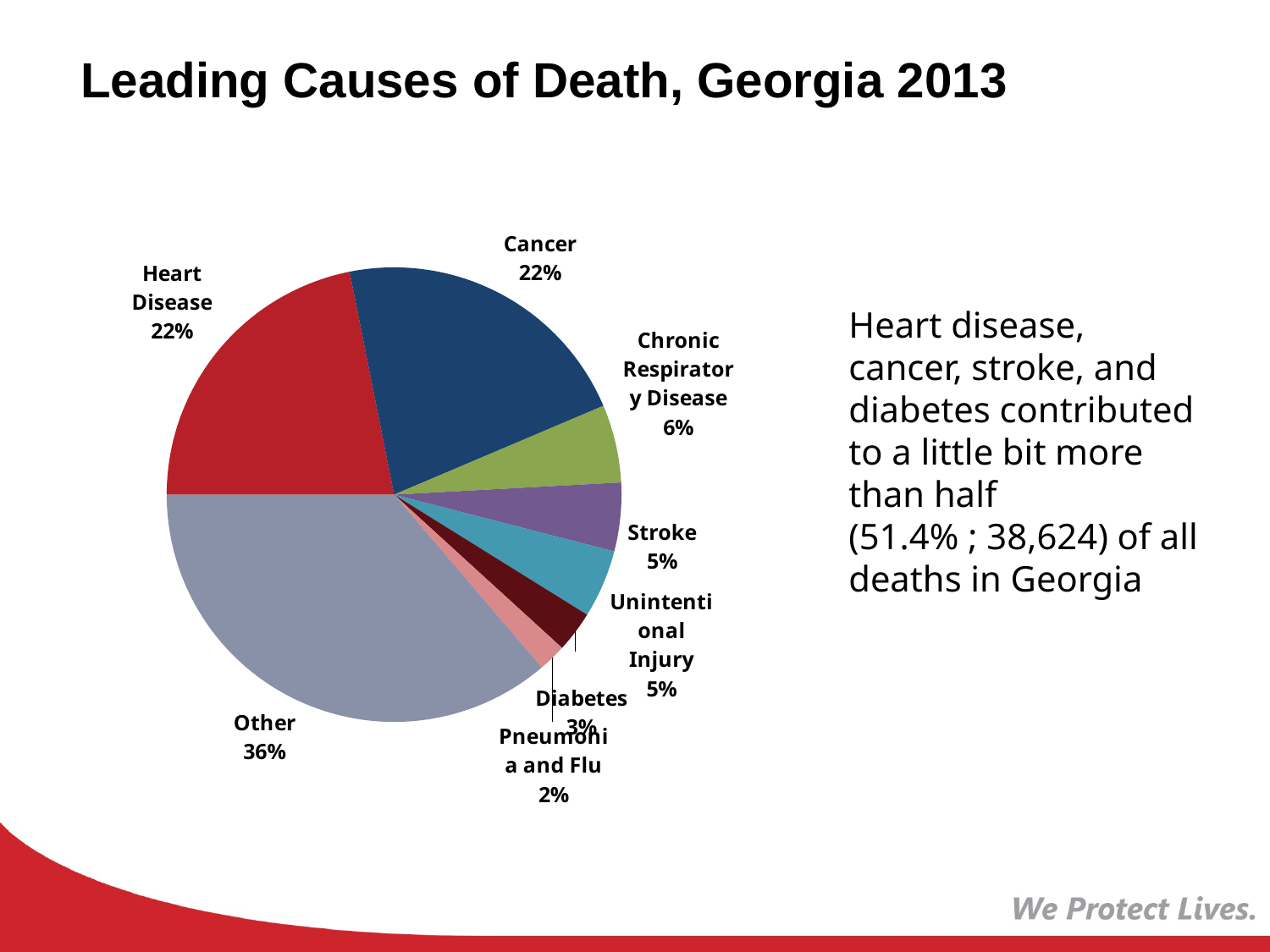
How many percentage points larger is the Other slice than the Cancer slice? 14 What share of deaths is attributed to Heart Disease in the pie chart? 22% What type of chart is shown on the slide? Pie chart How many categories are shown in the pie chart? 8 What percentage does the Cancer slice represent? 22% Which category has the smallest slice of the pie? Pneumonia and Flu Which is larger, the share for Chronic Respiratory Disease or the share for Stroke? Chronic Respiratory Disease What is the title of the slide containing the chart? Leading Causes of Death, Georgia 2013 What is the share for Chronic Respiratory Disease? 6% Which category has the largest slice of the pie? Other What is the combined share of Heart Disease and Cancer? 44% What percentage of deaths is shown for Diabetes? 3%